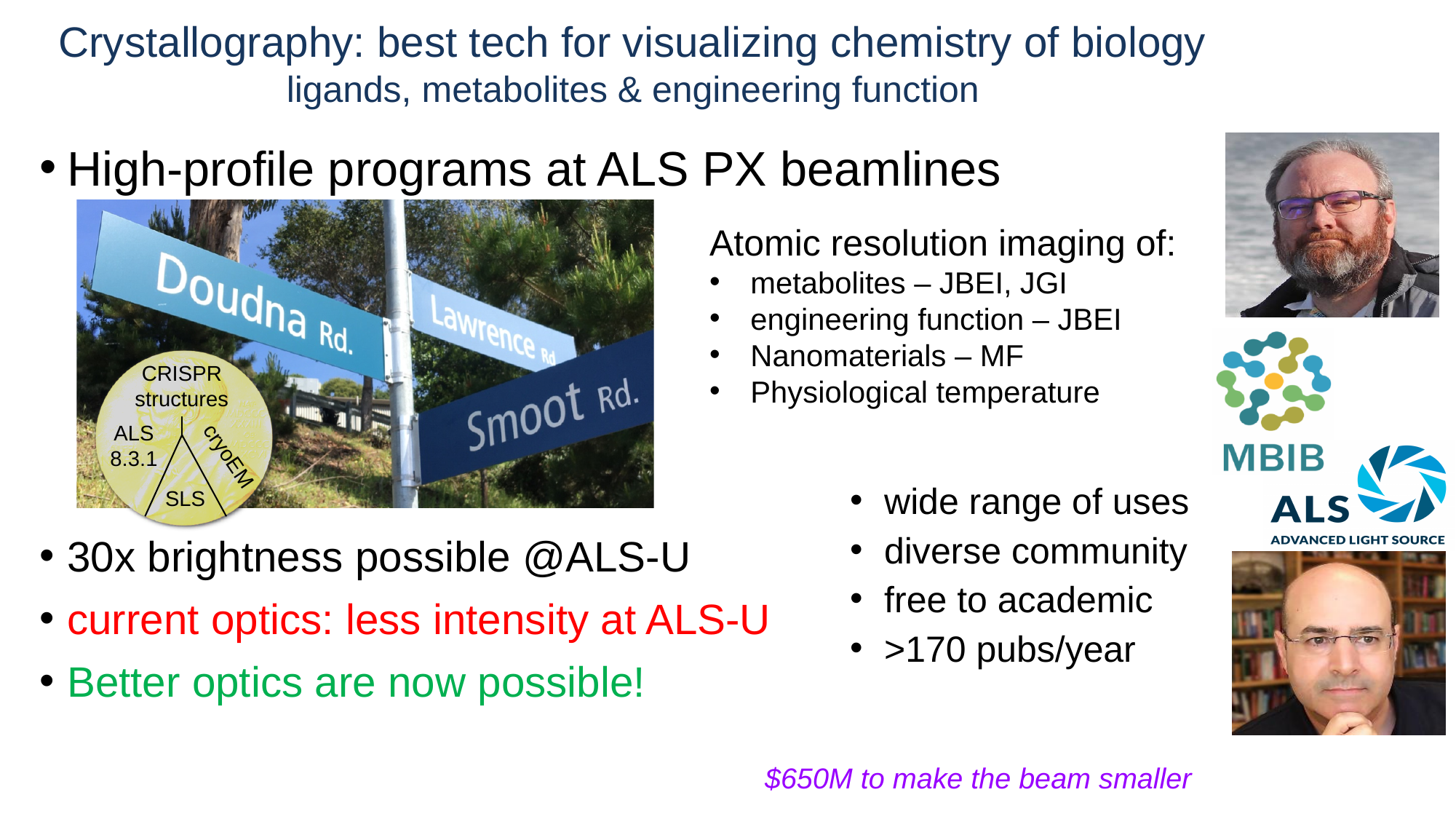
What is the title of the pie chart overlaid on the street-sign photo? CRISPR structures What kind of chart is the small chart labelled "CRISPR structures" on the slide? pie chart In the "CRISPR structures" pie chart, which slice is larger, cryoEM or SLS? cryoEM What are the labels of the three slices in the "CRISPR structures" pie chart? ALS 8.3.1, cryoEM, SLS In the "CRISPR structures" pie chart, which slice is larger, ALS 8.3.1 or SLS? ALS 8.3.1 Which slice of the "CRISPR structures" pie chart is the smallest? SLS How many slices does the "CRISPR structures" pie chart have? 3